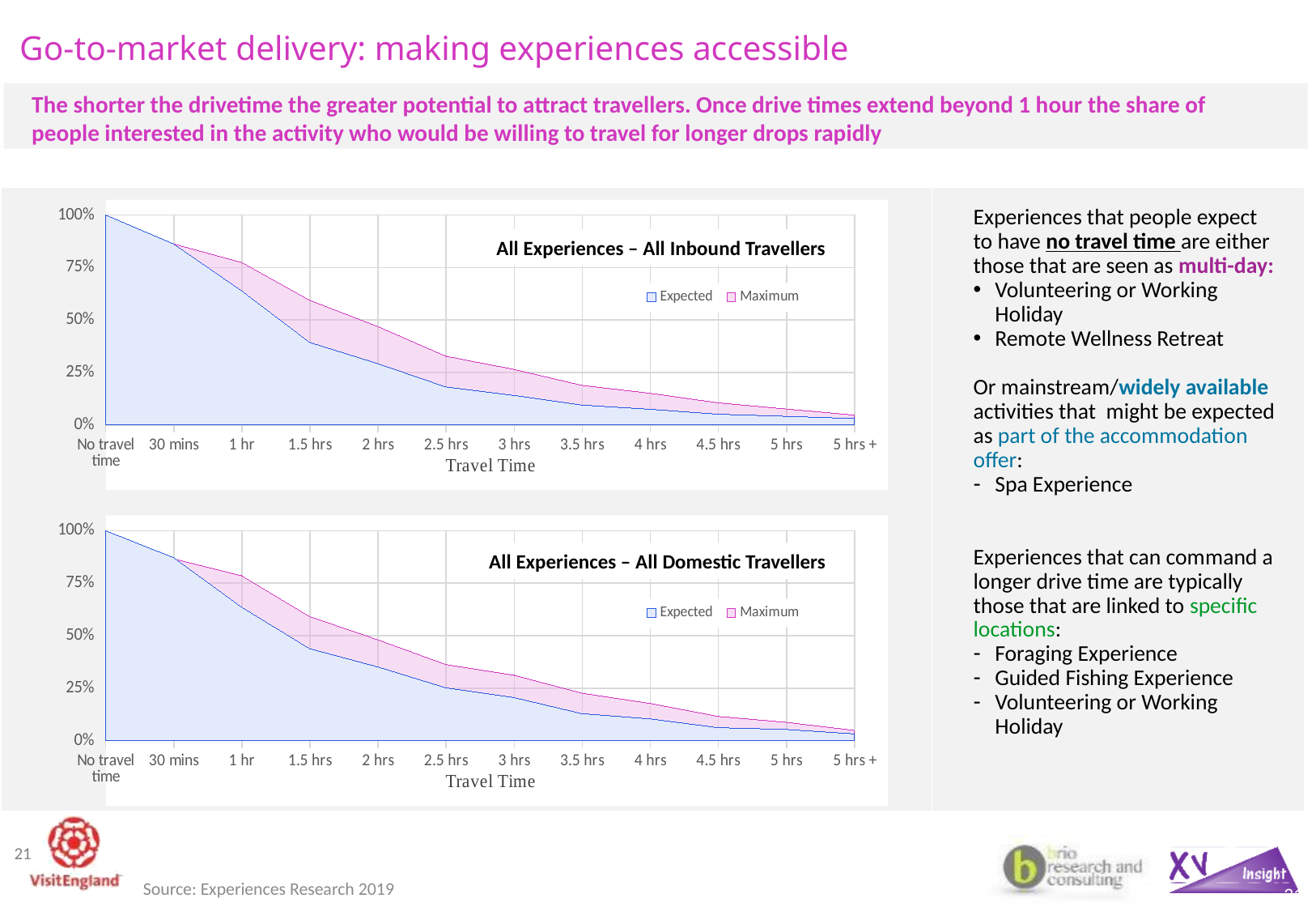
On the 'All Experiences – All Inbound Travellers' chart, which series is larger at 2 hrs, Expected or Maximum? Maximum How many travel time categories are shown on the x axis of the 'All Experiences – All Inbound Travellers' chart? 12 On the 'All Experiences – All Domestic Travellers' chart, is the Expected value at 30 mins greater or less than 75%? greater On the 'All Experiences – All Domestic Travellers' chart, which travel time category has the highest Expected value? No travel time On the 'All Experiences – All Inbound Travellers' chart, is the Expected value at 1.5 hrs greater or less than 50%? less On the 'All Experiences – All Inbound Travellers' chart, do the values rise or fall as travel time increases? fall What kind of chart is the 'All Experiences – All Inbound Travellers' chart? area chart On the 'All Experiences – All Domestic Travellers' chart, is the Maximum value at 2.5 hrs greater or less than 25%? greater On the 'All Experiences – All Inbound Travellers' chart, what is the Expected value at 'No travel time'? 100% How many series does the legend list on the 'All Experiences – All Domestic Travellers' chart? 2 On the 'All Experiences – All Domestic Travellers' chart, which travel time category has the lowest Maximum value? 5 hrs +